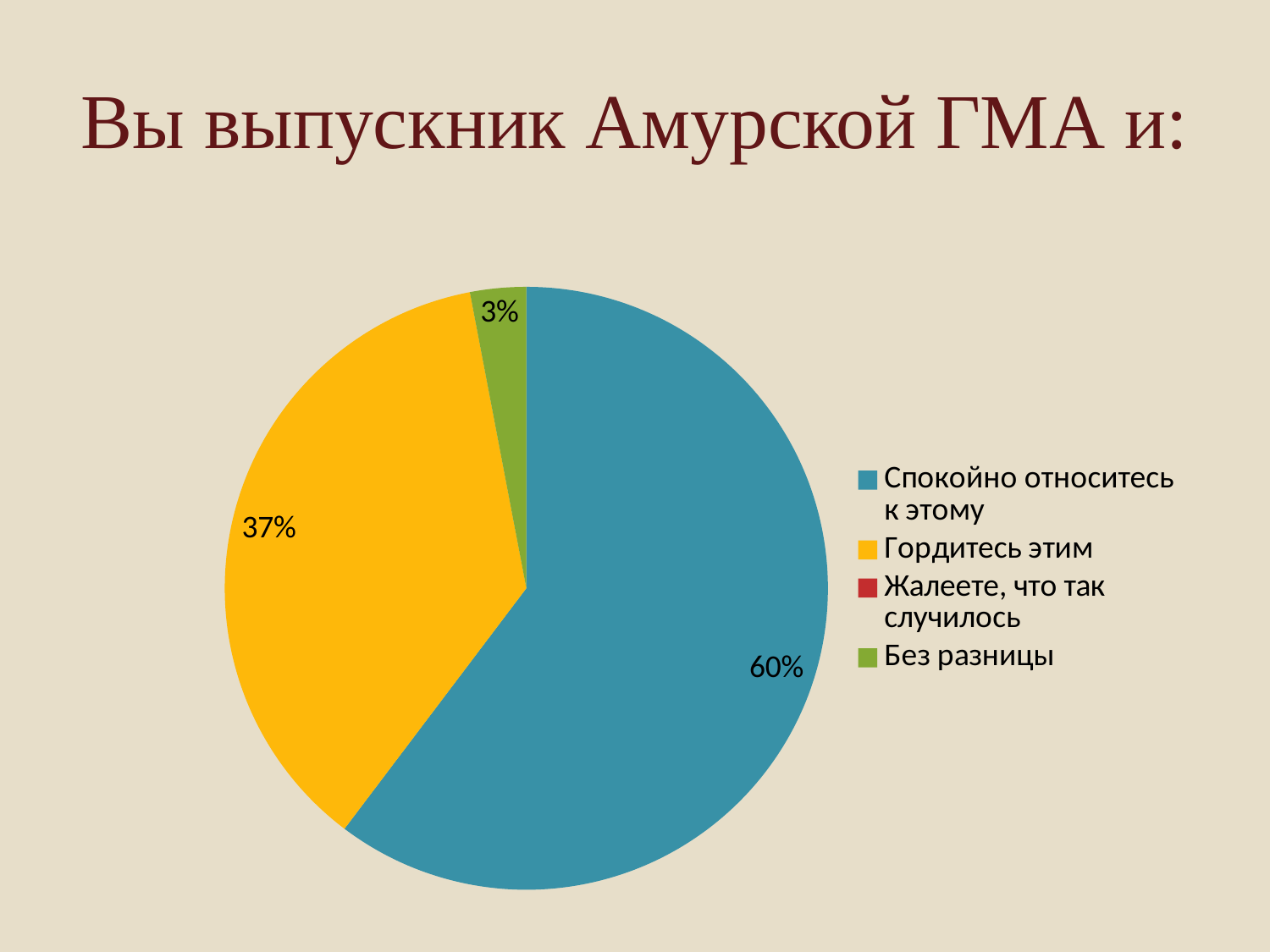
What is the difference in percentage points between "Спокойно относитесь к этому" and "Гордитесь этим"? 23 How many entries does the legend list? 4 Which of the labelled slices is the smallest? Без разницы Which category has the largest slice of the pie? Спокойно относитесь к этому What colour is the slice for "Гордитесь этим"? yellow What kind of chart is shown on the slide? pie chart What is the value shown for "Без разницы"? 3% What is the value shown for "Гордитесь этим"? 37% What share of the pie does "Спокойно относитесь к этому" take? 60% Is the value for "Спокойно относитесь к этому" greater or less than 50%? greater Which is larger: the slice for "Гордитесь этим" or the slice for "Без разницы"? Гордитесь этим What is the title of the chart? Вы выпускник Амурской ГМА и: